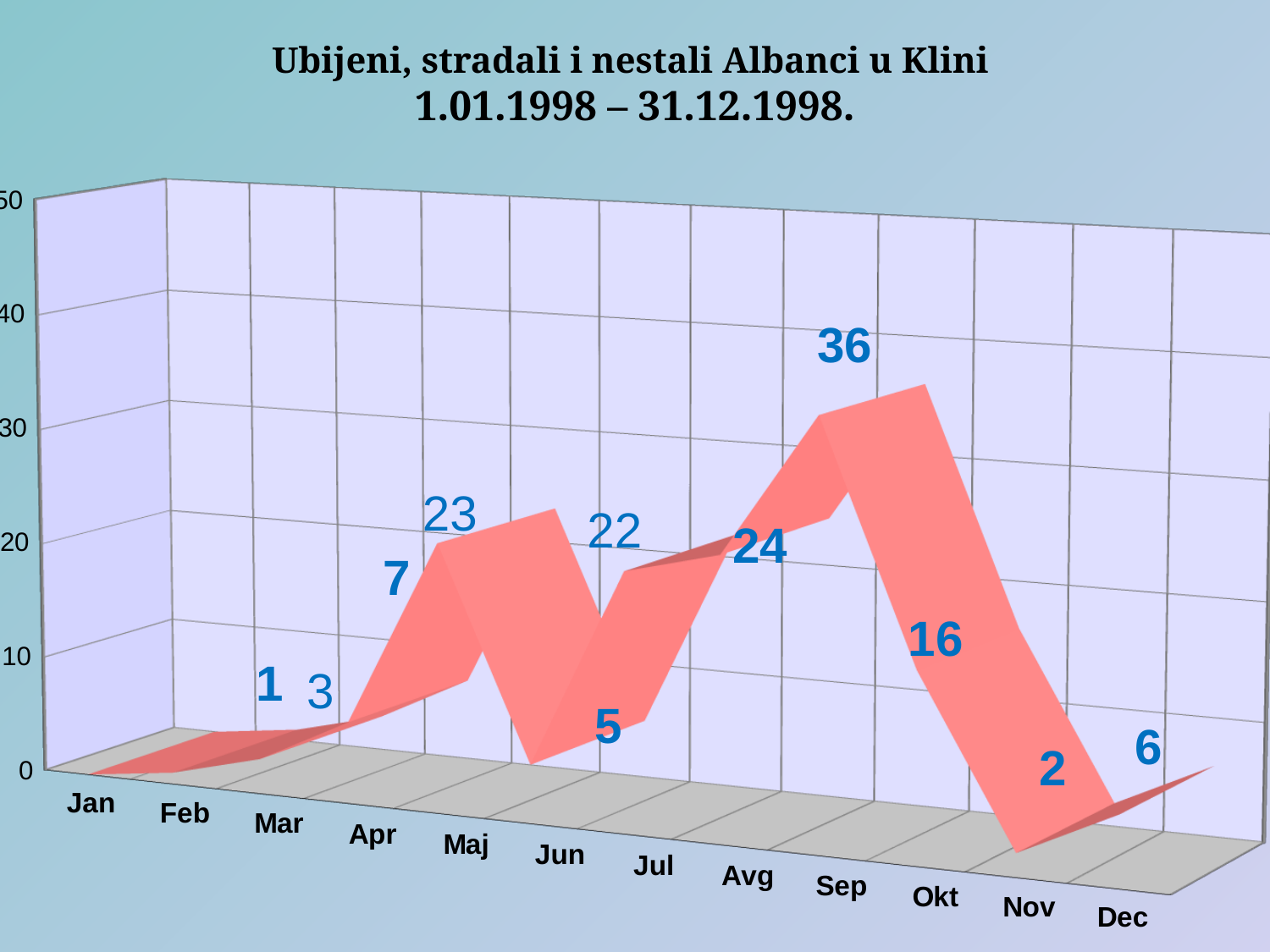
What is the value for Avg? 24 What is the value for Nov? 2 What kind of chart is this? 3D line chart What is the value for Maj? 23 Which month has the highest value? Sep What is the value for Sep? 36 What is the value for Okt? 16 What is the difference between the values for Sep and Okt? 20 Do the values rise or fall from Sep to Nov? fall Is the value for Jan greater or less than 10? less How many months are shown on the x axis? 12 Which is larger, the value for Maj or the value for Jun? Maj